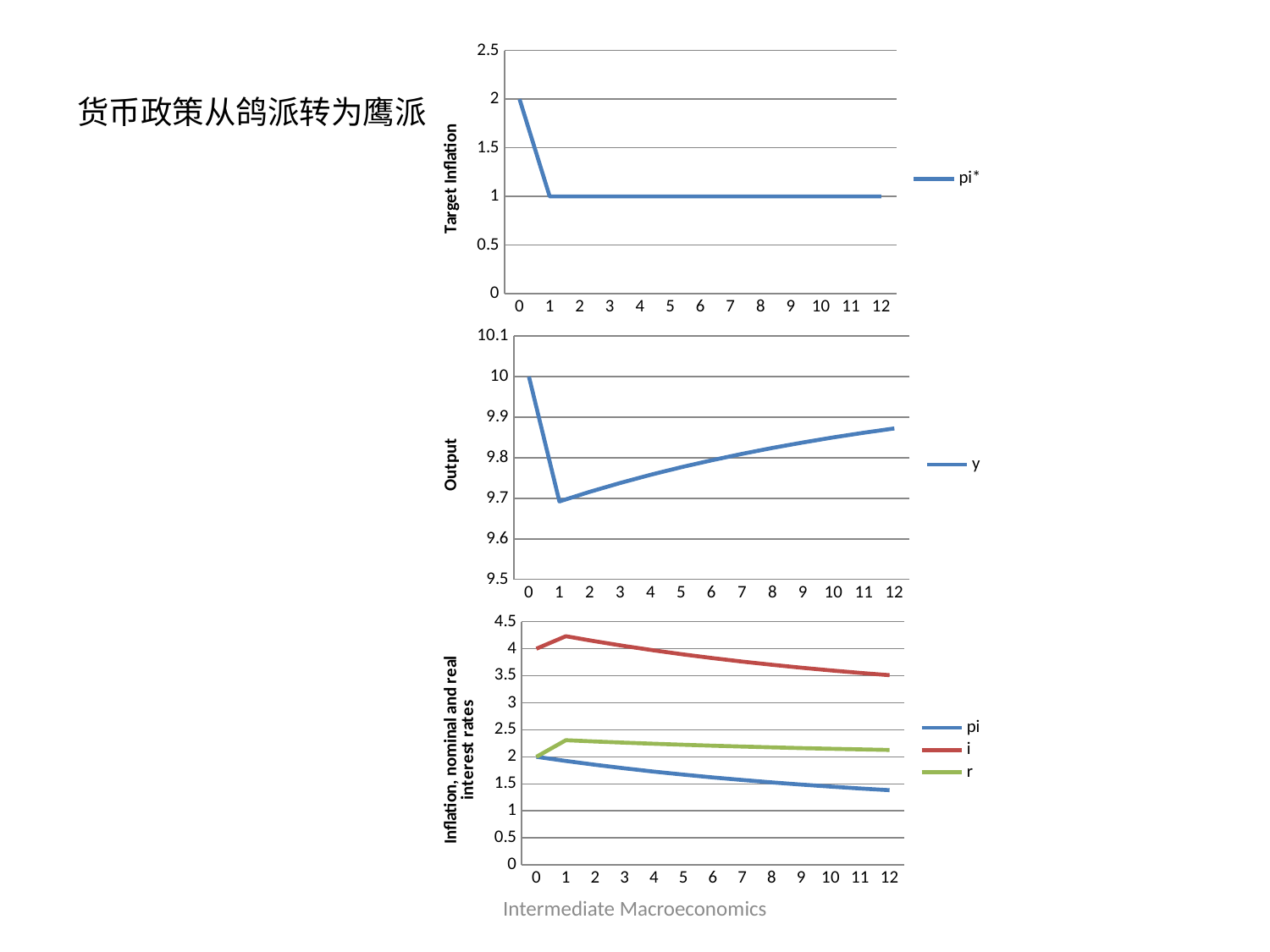
In the top chart (Target Inflation), what is the value of pi* at period 0? 2 In the bottom chart (Inflation, nominal and real interest rates), which series has the highest value at period 12? i In the bottom chart (Inflation, nominal and real interest rates), which is larger at period 6, r or pi? r In the bottom chart (Inflation, nominal and real interest rates), is the value of i at period 12 greater or less than 4? less In the top chart (Target Inflation), does pi* rise or fall between period 0 and period 1? fall In the middle chart (Output), is the value of y at period 1 greater or less than 9.8? less In the top chart (Target Inflation), what is the value of pi* at period 12? 1 How many series does the legend of the bottom chart list? 3 In the middle chart (Output), what is the value of y at period 0? 10 In the middle chart (Output), does y rise or fall from period 1 to period 12? rise What kind of chart is the middle chart (Output)? line chart In the bottom chart (Inflation, nominal and real interest rates), what is the value of i at period 0? 4